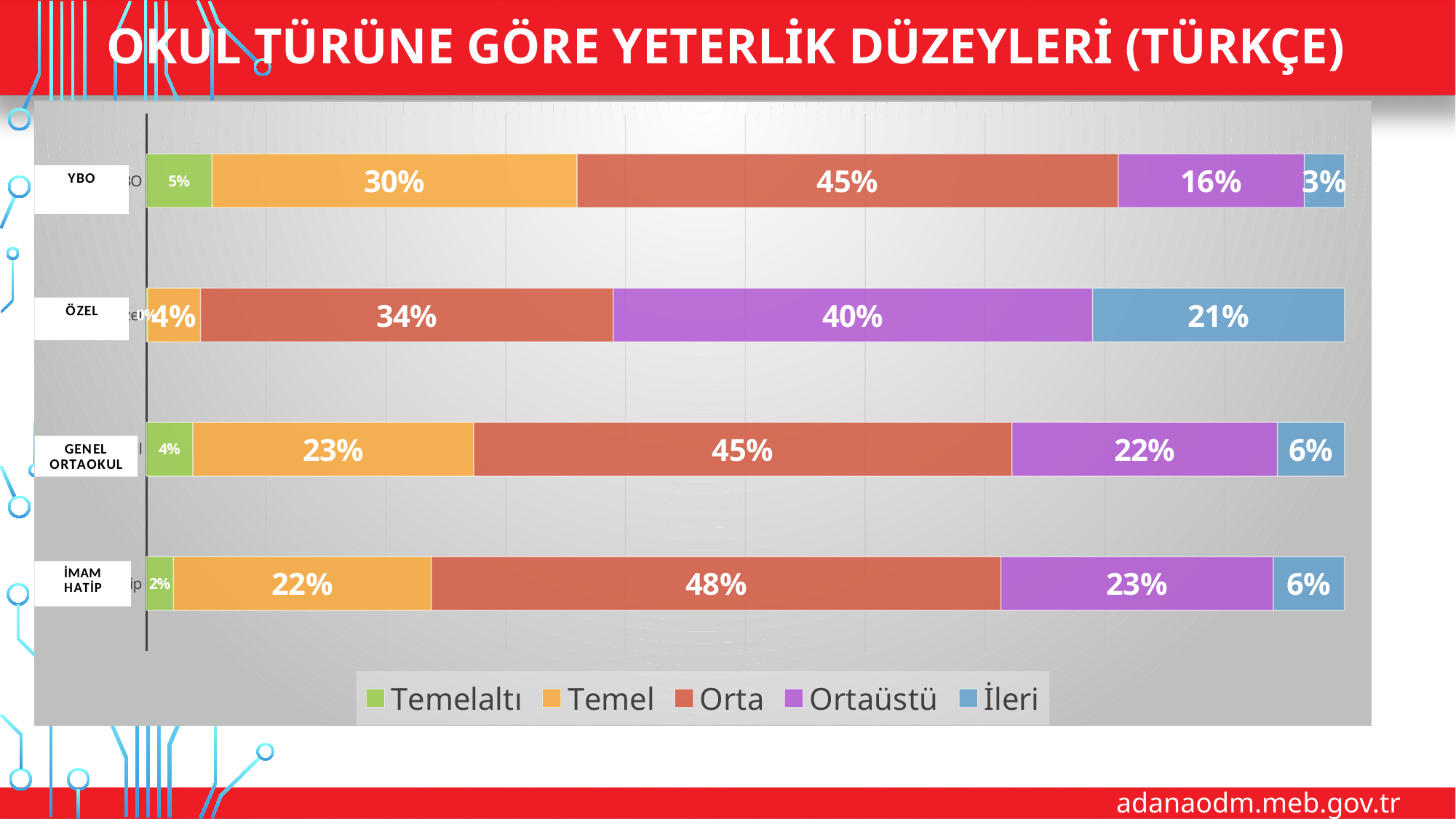
What is the Orta value for YBO? 45% Which school type has the highest İleri value? ÖZEL What is the difference between the Ortaüstü value for ÖZEL and the Ortaüstü value for YBO? 24% Which has the larger Temel value, YBO or GENEL ORTAOKUL? YBO Which school type has the highest Orta value? İMAM HATİP How many school types are shown in the chart? 4 What is the Ortaüstü value for GENEL ORTAOKUL? 22% What kind of chart is shown on the slide? Stacked bar chart What is the İleri value for ÖZEL? 21% What is the Temel value for İMAM HATİP? 22% Which school type has the lowest Ortaüstü value? YBO How many series does the legend list? 5